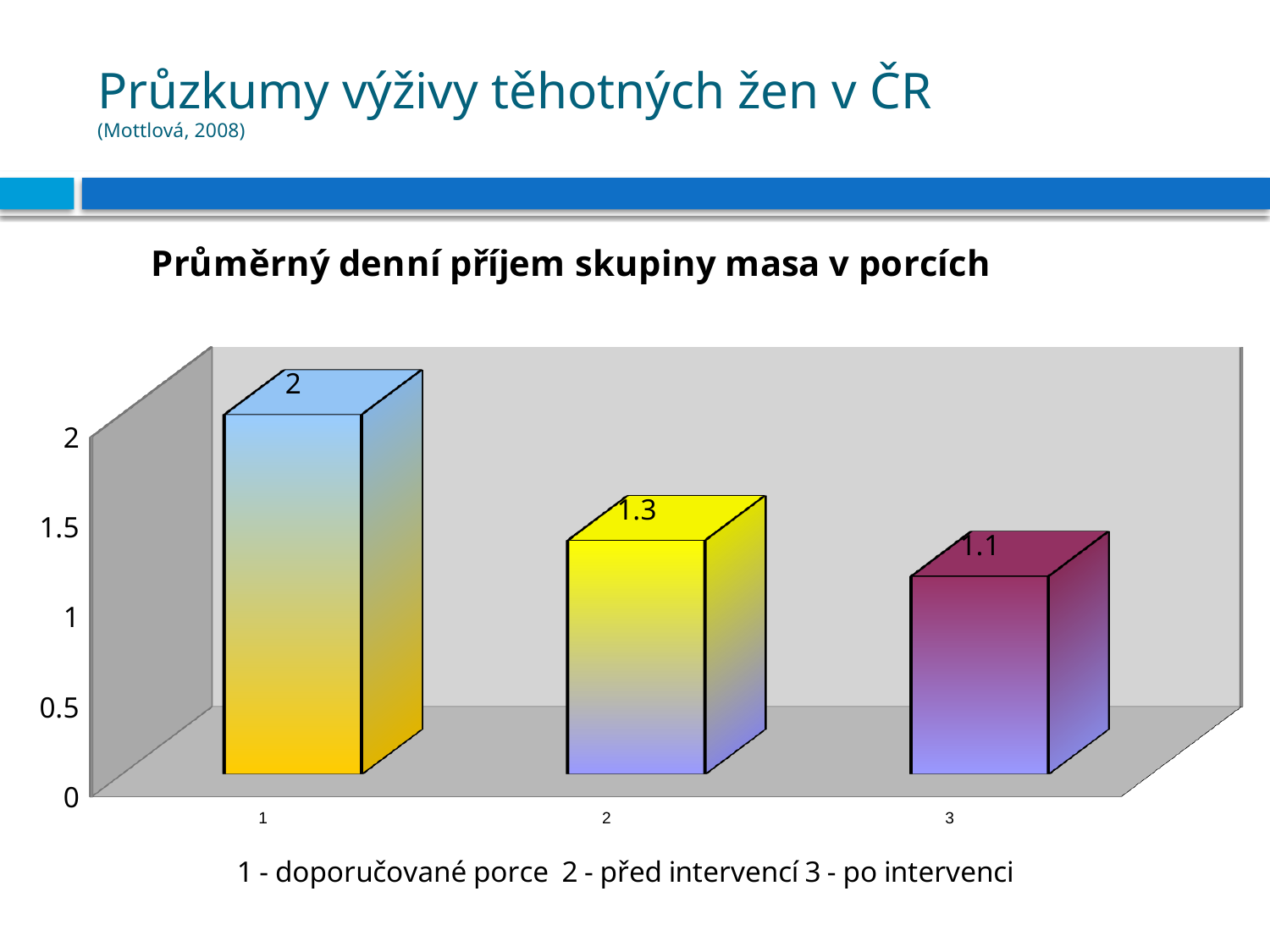
What is the value for category 3 in the chart? 1.1 How many categories are shown in the chart? 3 What is the value for category 1 in the chart? 2 Is the value for category 3 greater or less than 1.5? less What is the title of the chart? Průměrný denní příjem skupiny masa v porcích What is the difference between the values for category 2 and category 3? 0.2 Which category has the highest value? 1 What kind of chart is shown on the slide? bar chart What is the difference between the values for category 1 and category 2? 0.7 What is the value for category 2 in the chart? 1.3 Which is larger, the value for category 2 or category 3? category 2 Which category has the lowest value? 3